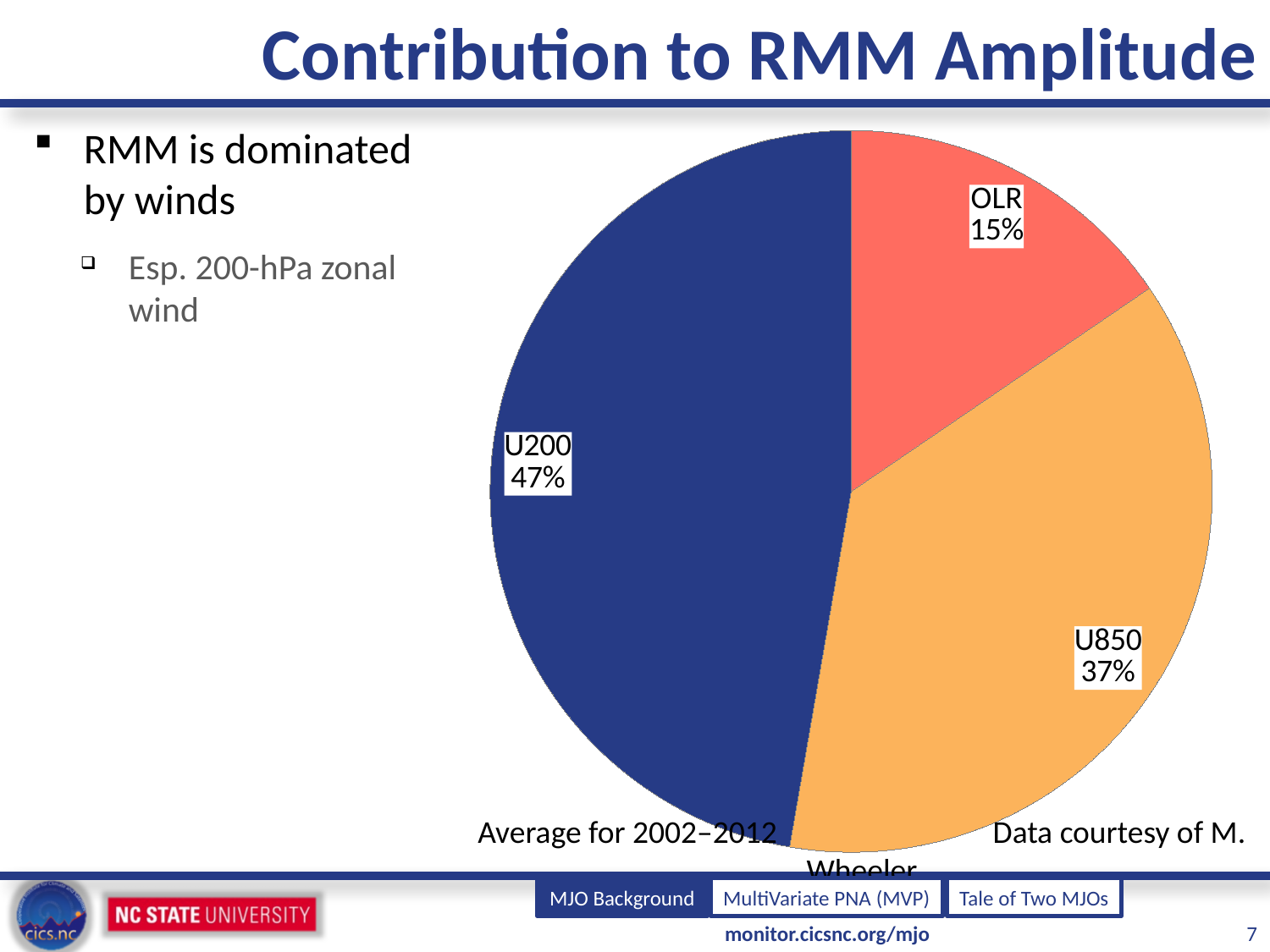
Which component contributes the smallest share to RMM amplitude? OLR What colour is the U200 slice of the pie chart? dark blue What is the difference in percentage points between the U200 and U850 contributions? 10 What percentage of RMM amplitude is contributed by U200? 47% What is the difference in percentage points between the U850 and OLR contributions? 22 What percentage of RMM amplitude is contributed by OLR? 15% Which component contributes the largest share to RMM amplitude? U200 How many slices does the pie chart have? 3 What is the title of the slide containing the pie chart? Contribution to RMM Amplitude What percentage of RMM amplitude is contributed by U850? 37% Which contributes more to RMM amplitude, U850 or OLR? U850 What type of chart is shown on the slide? pie chart